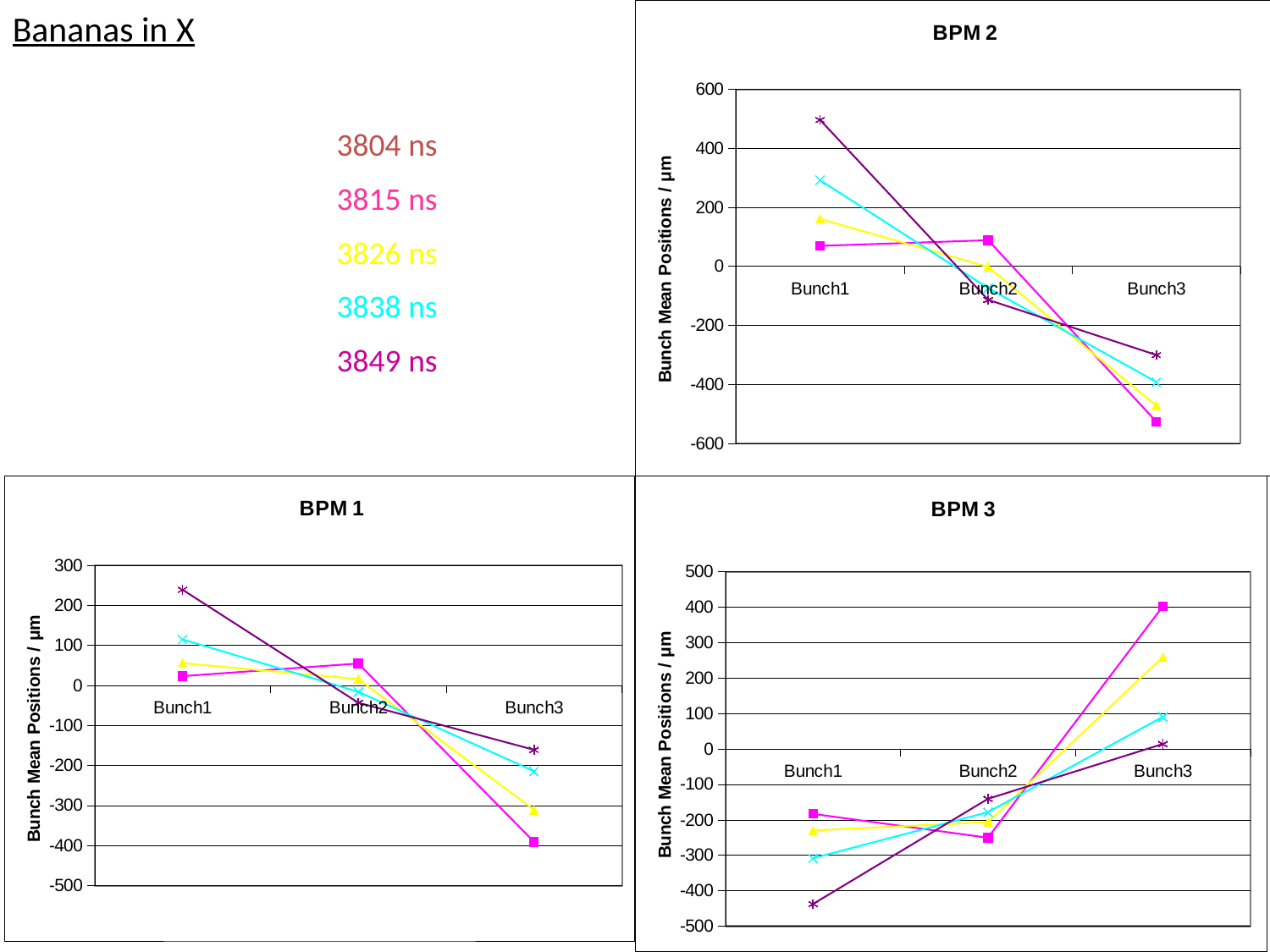
In the BPM 2 chart, is the value of the purple star series at Bunch1 greater or less than 400? greater What kind of chart is the BPM 2 chart? line chart In the BPM 1 chart, do the values rise or fall from Bunch1 to Bunch3? fall In the BPM 3 chart, which series has the highest value at Bunch3? the magenta square series In the BPM 1 chart, which series has the lowest value at Bunch3? the magenta square series How many bunch categories are shown on the x axis of the BPM 1 chart? 3 In the BPM 1 chart, is the value of the purple star series at Bunch1 greater or less than 200? greater What is the y-axis label of the BPM 3 chart? Bunch Mean Positions / µm In the BPM 2 chart, is the value of the magenta square series at Bunch3 greater or less than -400? less In the BPM 3 chart, do the values rise or fall from Bunch1 to Bunch3? rise In the BPM 2 chart, which series has the highest value at Bunch1? the purple star series